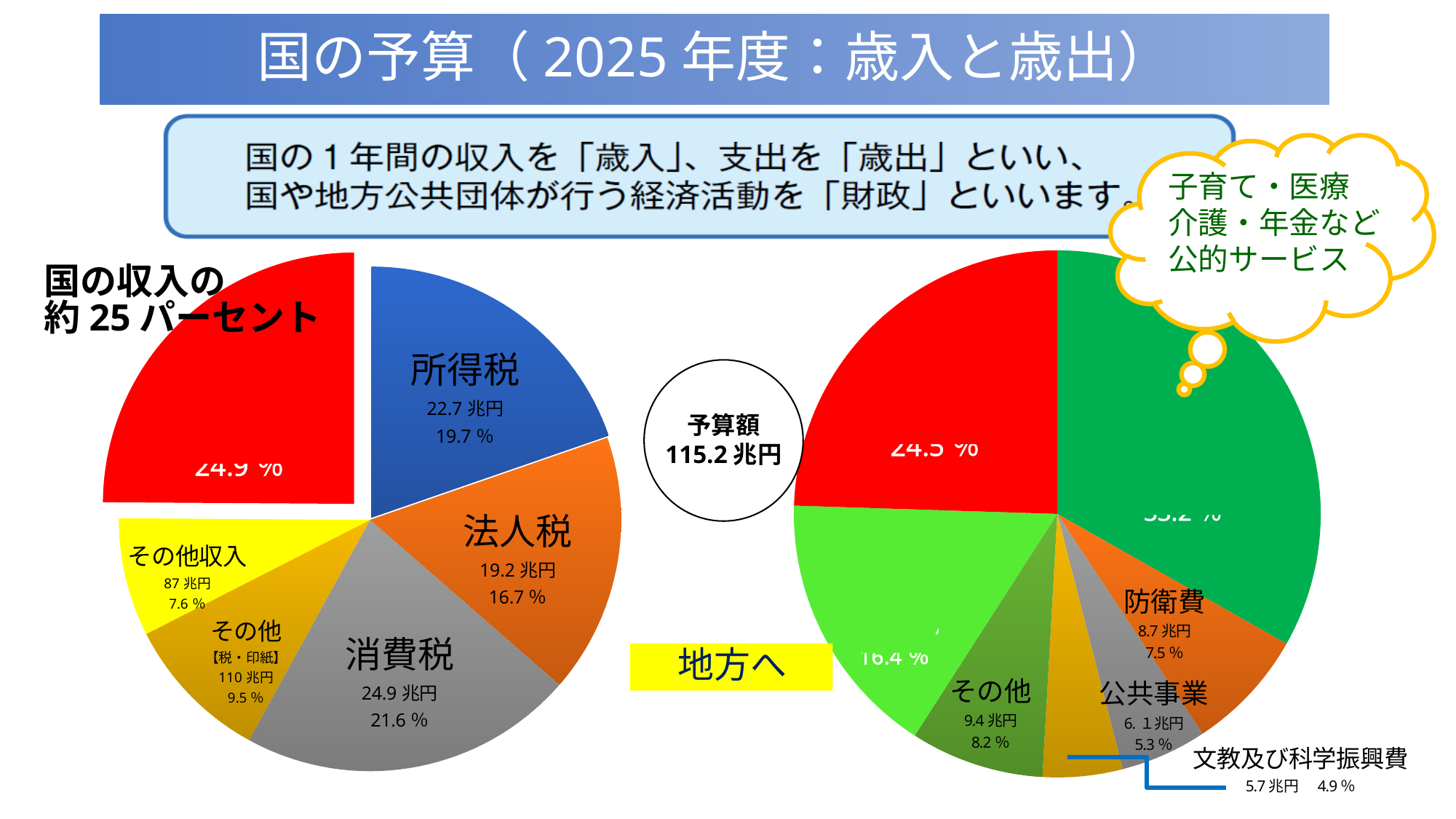
In the right pie chart, what is the value for 防衛費? 8.7 兆円 What total budget amount (予算額) is shown between the two pie charts? 115.2 兆円 In the left pie chart, what is the difference in 兆円 between 消費税 and 法人税? 5.7 兆円 In the right pie chart, what percentage is shown for 公共事業? 5.3 % In the left pie chart, what percentage is shown for 法人税? 16.7 % What kind of charts are shown on the slide? Pie charts How many slices does the left pie chart have? 6 In the left pie chart, what percentage is shown for 消費税? 21.6 % In the right pie chart, what is the value for 文教及び科学振興費? 5.7 兆円 In the left pie chart, which is larger, 所得税 or 法人税? 所得税 In the right pie chart, what is the difference in 兆円 between 防衛費 and 公共事業? 2.6 兆円 In the left pie chart, what is the value for 所得税? 22.7 兆円